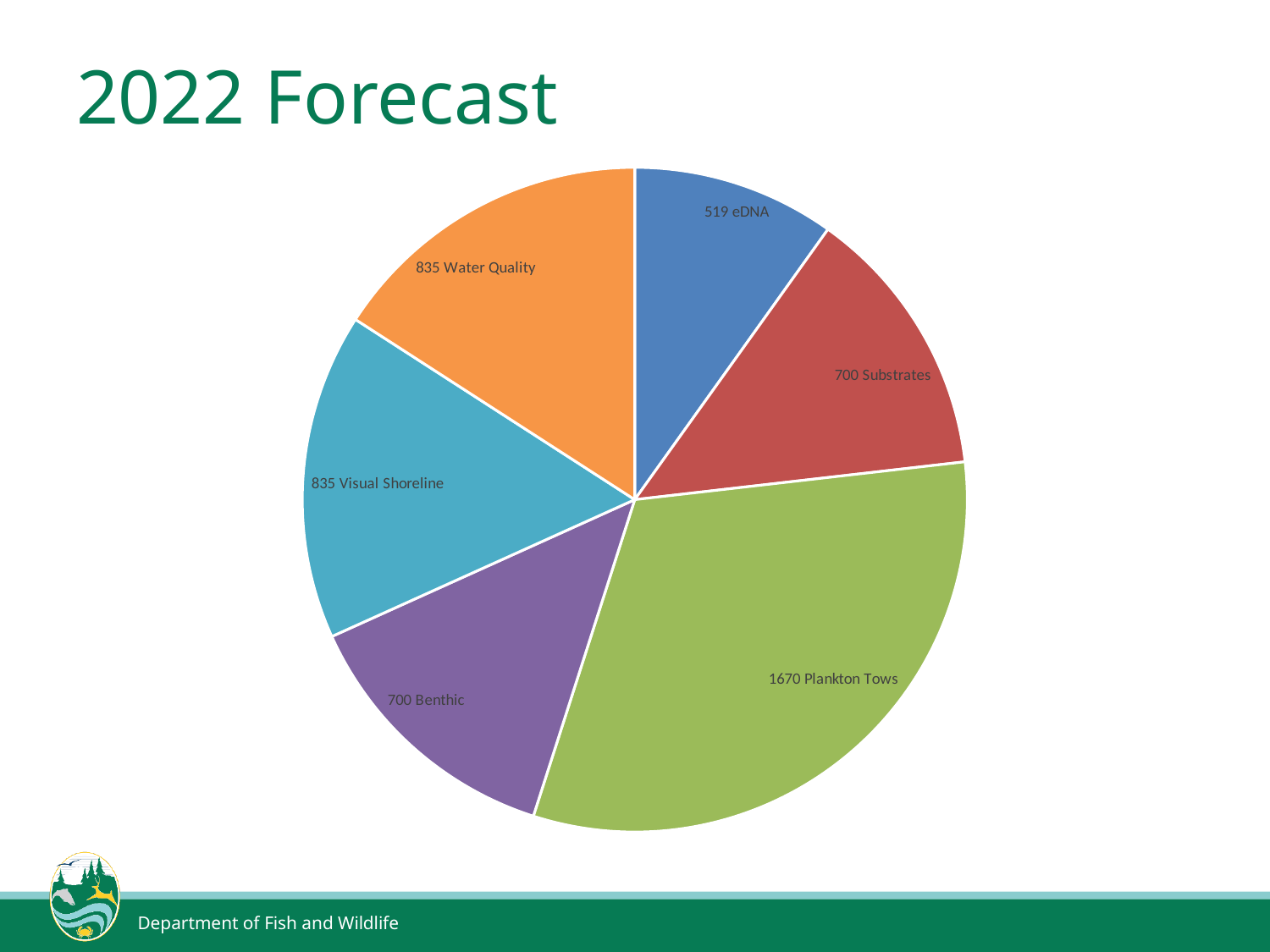
What is the value for eDNA? 519 What is the difference between the Substrates value and the eDNA value? 181 What colour is the Plankton Tows slice? Green How many slices does the pie chart have? 6 Which category has the smallest slice of the pie? eDNA What is the value for Plankton Tows? 1670 What kind of chart is shown on the slide? Pie chart What is the difference between the Plankton Tows value and the Water Quality value? 835 What is the title of the slide containing the pie chart? 2022 Forecast Which is larger, the value for Water Quality or the value for Benthic? Water Quality What is the value for Visual Shoreline? 835 Which category has the largest slice of the pie? Plankton Tows